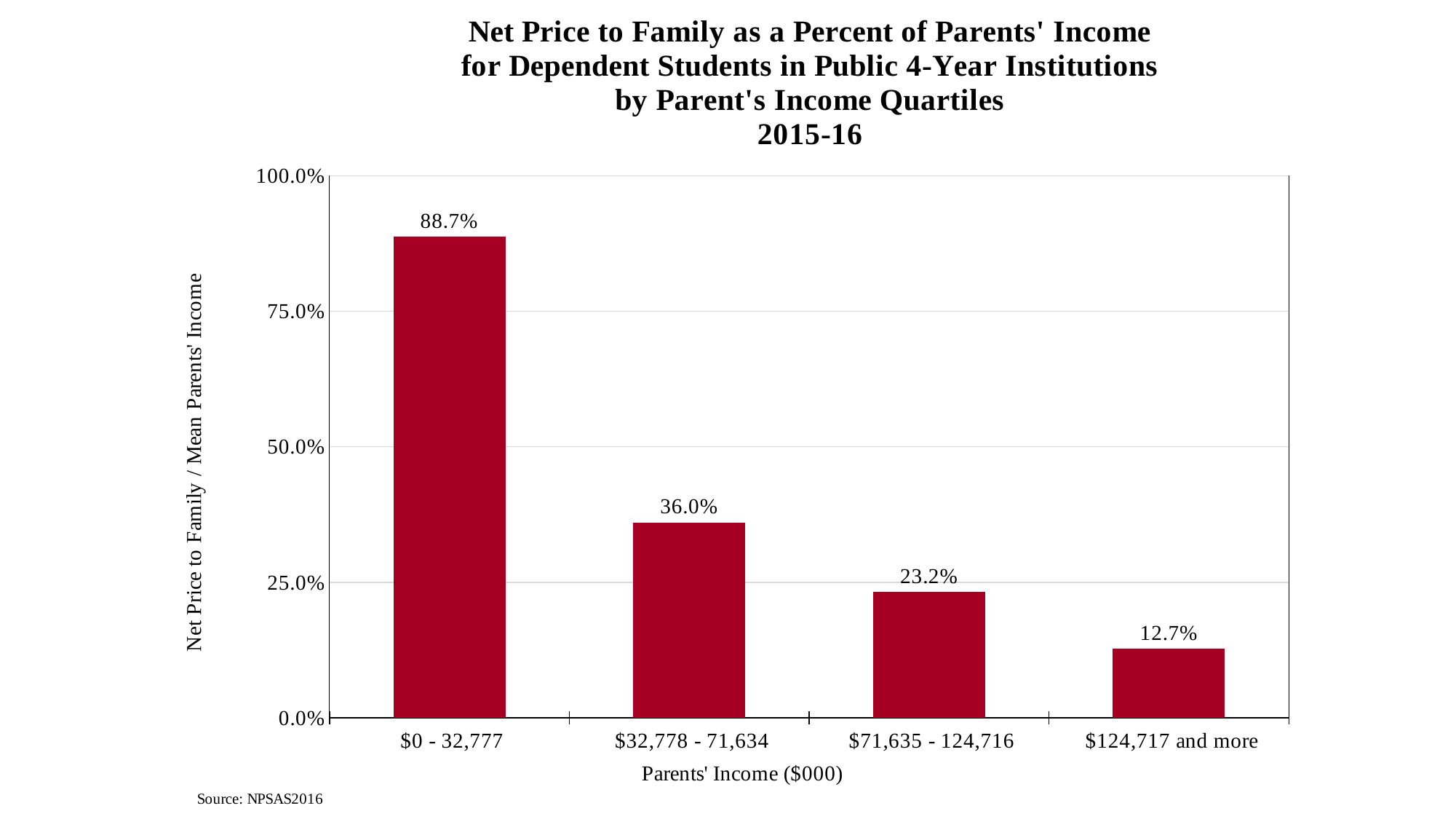
Which income quartile has the lowest net price as a percent of parents' income? $124,717 and more What is the value shown for the $124,717 and more income quartile? 12.7% What is the difference between the values for the $71,635 - 124,716 and $124,717 and more quartiles? 10.5% Do the values rise or fall as parents' income increases along the x axis? Fall What kind of chart is shown on the slide? Bar chart What is the value shown for the $71,635 - 124,716 income quartile? 23.2% What is the value shown for the $32,778 - 71,634 income quartile? 36.0% How many income quartiles are shown on the chart? 4 What is the net price to family as a percent of parents' income for the $0 - 32,777 income quartile? 88.7% Which is larger, the value for $32,778 - 71,634 or the value for $71,635 - 124,716? $32,778 - 71,634 What is the difference between the values for the $0 - 32,777 and $32,778 - 71,634 quartiles? 52.7% Which income quartile has the highest net price as a percent of parents' income? $0 - 32,777